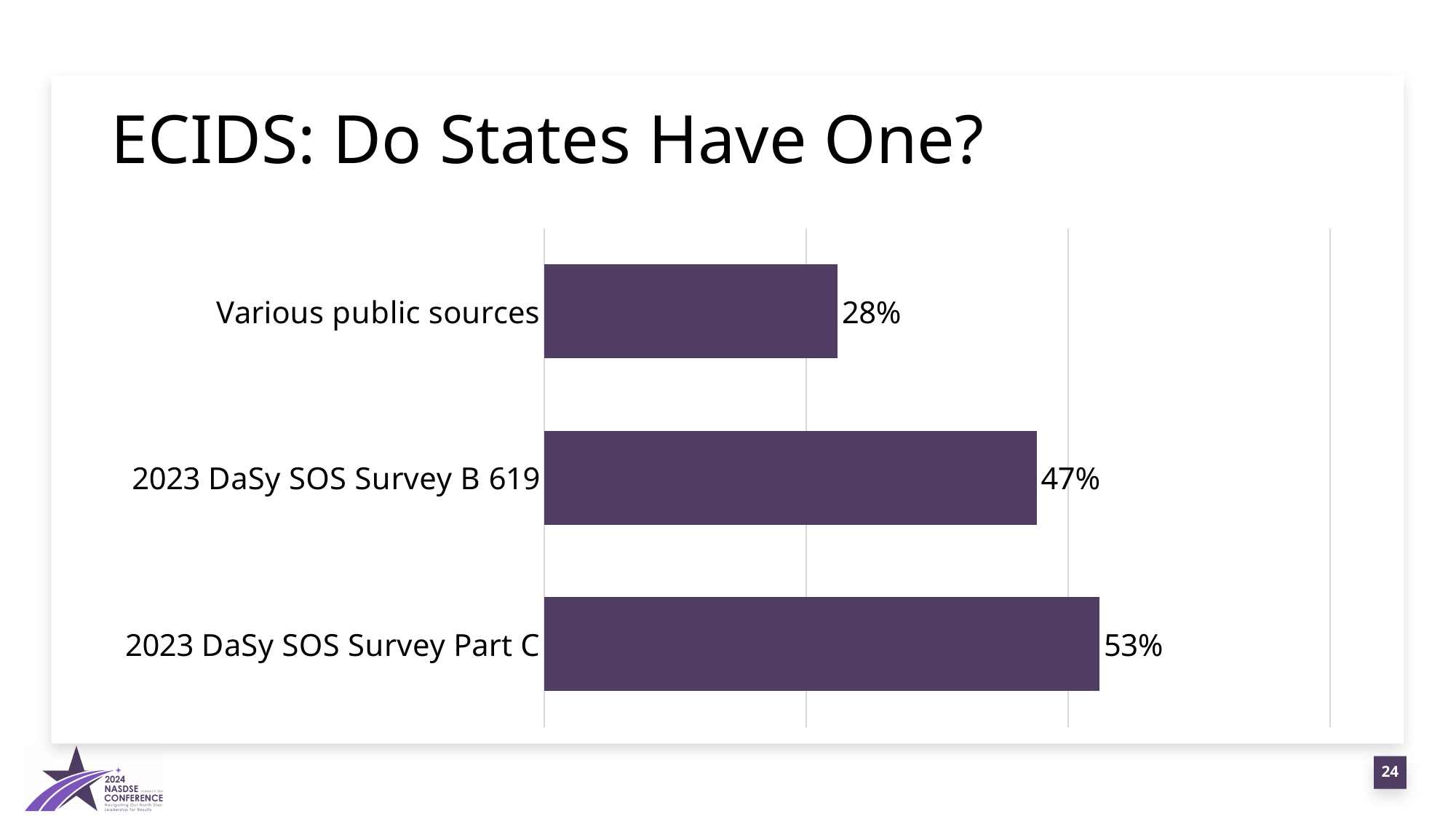
What is the difference between the values for 2023 DaSy SOS Survey Part C and Various public sources? 25% Which category has the lowest value? Various public sources What colour are the bars in the chart? Purple What is the title of the slide containing the chart? ECIDS: Do States Have One? What is the value for 2023 DaSy SOS Survey B 619? 47% Which is larger, the value for 2023 DaSy SOS Survey B 619 or the value for Various public sources? 2023 DaSy SOS Survey B 619 Which category has the highest value? 2023 DaSy SOS Survey Part C What is the value for 2023 DaSy SOS Survey Part C? 53% What is the value for Various public sources? 28% What kind of chart is shown on the slide? Bar chart How many categories are shown in the chart? 3 What is the difference between the values for 2023 DaSy SOS Survey Part C and 2023 DaSy SOS Survey B 619? 6%